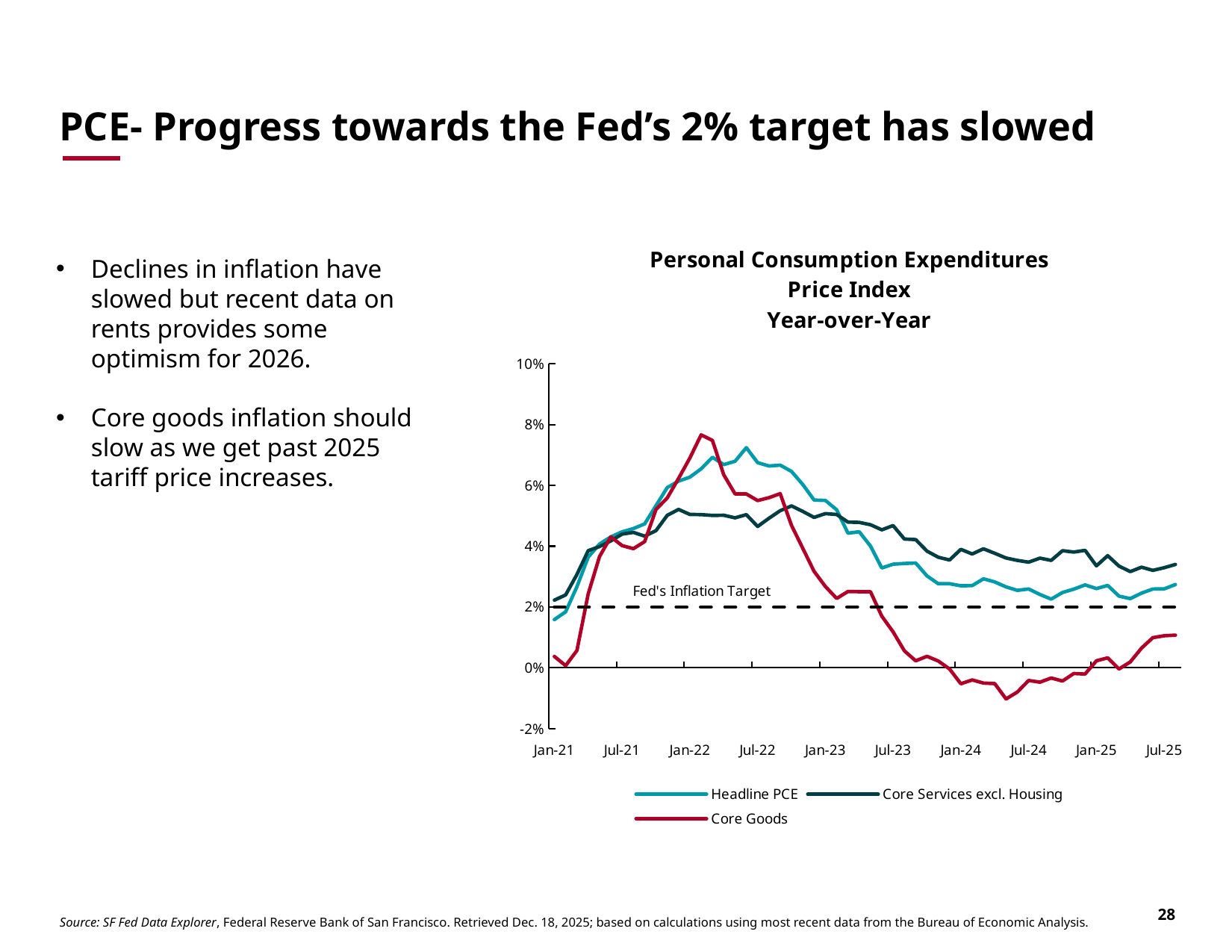
How many series does the chart's legend list? 3 How many date labels are shown on the x axis? 10 At what level is the dashed line labelled "Fed's Inflation Target" drawn? 2% At Jul-25, which is larger: Core Services excl. Housing or Headline PCE? Core Services excl. Housing Is the value of Headline PCE at Jul-25 greater or less than 4%? less What kind of chart is shown on the slide? line chart Which series is the only one that falls below 0% during the period shown? Core Goods Is the peak value of the Core Goods line greater or less than 6%? greater At Jan-24, which is larger: Headline PCE or Core Goods? Headline PCE Does the Headline PCE line rise or fall between Jul-22 and Jul-25? fall What is the title of the chart? Personal Consumption Expenditures Price Index Year-over-Year Is the value of Core Goods at Jul-24 greater or less than 0%? less